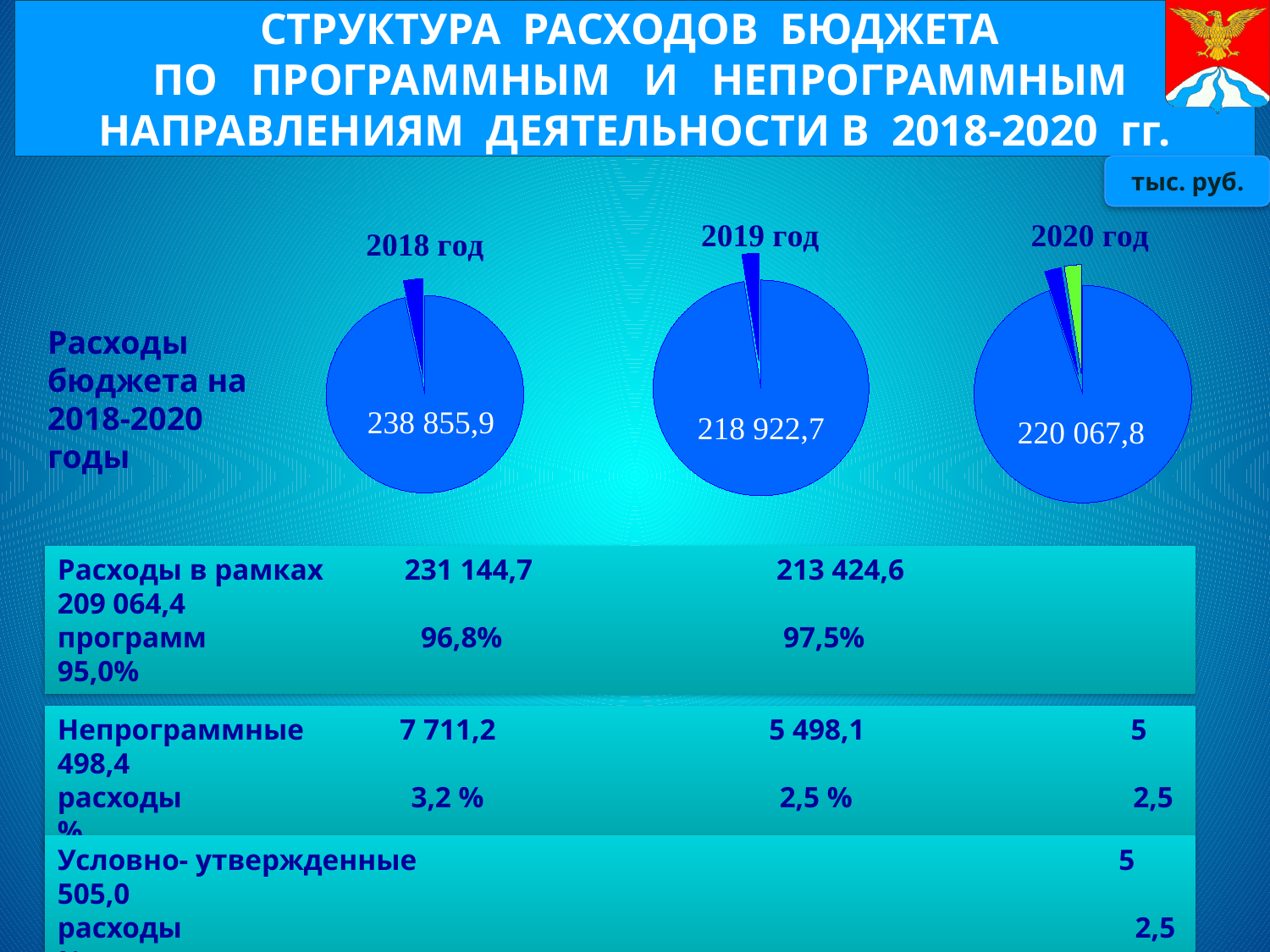
What kind of charts are shown on the slide? Pie charts What total value is printed on the 2020 год pie chart? 220 067,8 What is the difference between the totals printed on the 2018 год and 2019 год pie charts? 19 933,2 Is the total printed on the 2018 год pie chart larger or smaller than the total on the 2020 год pie chart? Larger Which year's pie chart shows the highest total budget expenditure? 2018 год How many pie charts are on the slide? 3 What total value is printed on the 2018 год pie chart? 238 855,9 In what units are the values on the pie charts given, according to the label in the top right? тыс. руб. What share of the 2018 год pie does the large slice (расходы в рамках программ) represent? 96,8% Which year's pie chart shows the lowest total budget expenditure? 2019 год How many slices does the 2020 год pie chart have? 3 What total value is printed on the 2019 год pie chart? 218 922,7